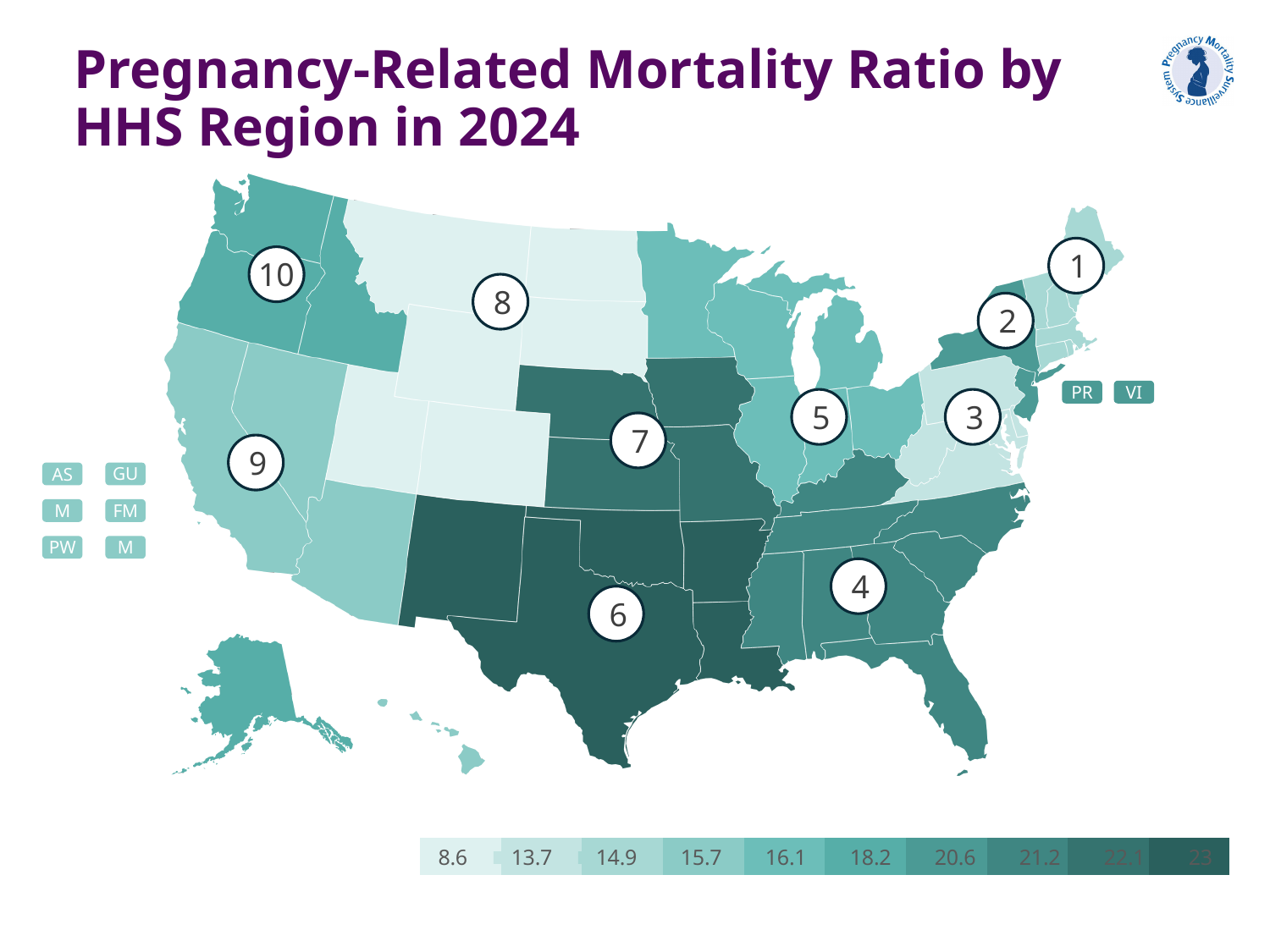
What is the title of the chart? Pregnancy-Related Mortality Ratio by HHS Region in 2024 How many numbered HHS regions are shown on the map? 10 What kind of chart is shown on the slide? Map (choropleth map) Which HHS region is shaded darkest, indicating the highest pregnancy-related mortality ratio? Region 6 Which has the higher pregnancy-related mortality ratio, Region 6 or Region 8? Region 6 Which has the higher pregnancy-related mortality ratio, Region 7 or Region 8? Region 7 What is the highest value shown on the colour legend? 23 What is the lowest value shown on the colour legend? 8.6 Which has the higher pregnancy-related mortality ratio, Region 9 or Region 6? Region 6 Which HHS region is shaded lightest, indicating the lowest pregnancy-related mortality ratio? Region 8 How many distinct values are listed on the colour legend? 10